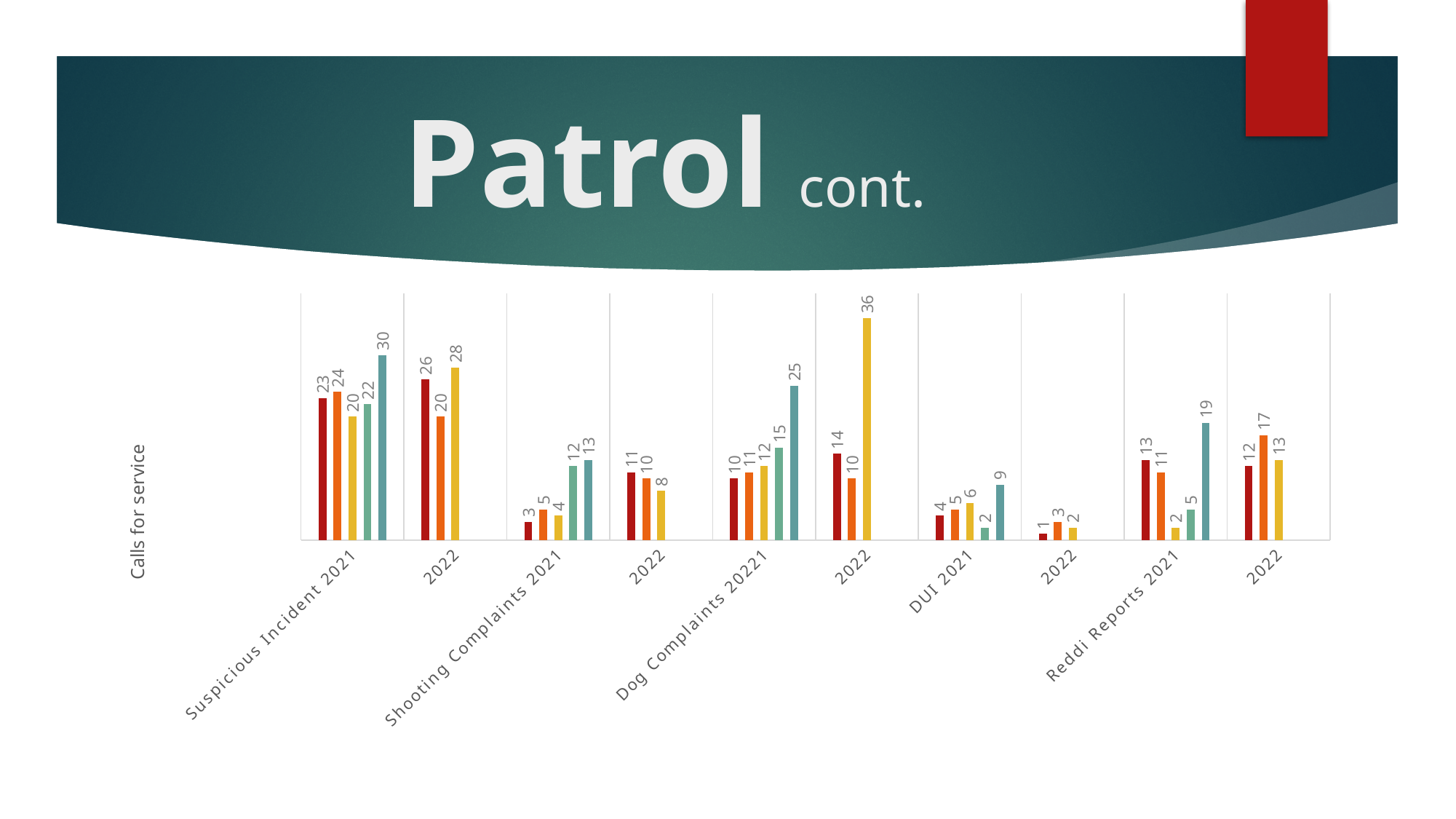
What is the difference between the teal bar (19) and the yellow bar (2) in the Reddi Reports 2021 group? 17 What is the value of the smallest bar in the DUI 2022 group? 1 What is the label on the vertical axis of the chart? Calls for service What is the total of the three bars in the Shooting Complaints 2022 group (11, 10, 8)? 29 What is the value of the dark red (first) bar in the Reddi Reports 2021 group? 13 How many categories are shown along the x axis of the chart? 10 Which is larger: the dark red bar in Suspicious Incident 2022 (26) or the dark red bar in Dog Complaints 2022 (14)? Suspicious Incident 2022 What type of chart is shown on the slide? bar chart What is the value of the teal (rightmost) bar in the Suspicious Incident 2021 group? 30 Which category group contains the highest single bar on the chart? Dog Complaints 2022 How many bars are in the Suspicious Incident 2021 group? 5 What is the value of the tallest bar in the Dog Complaints 2022 group? 36